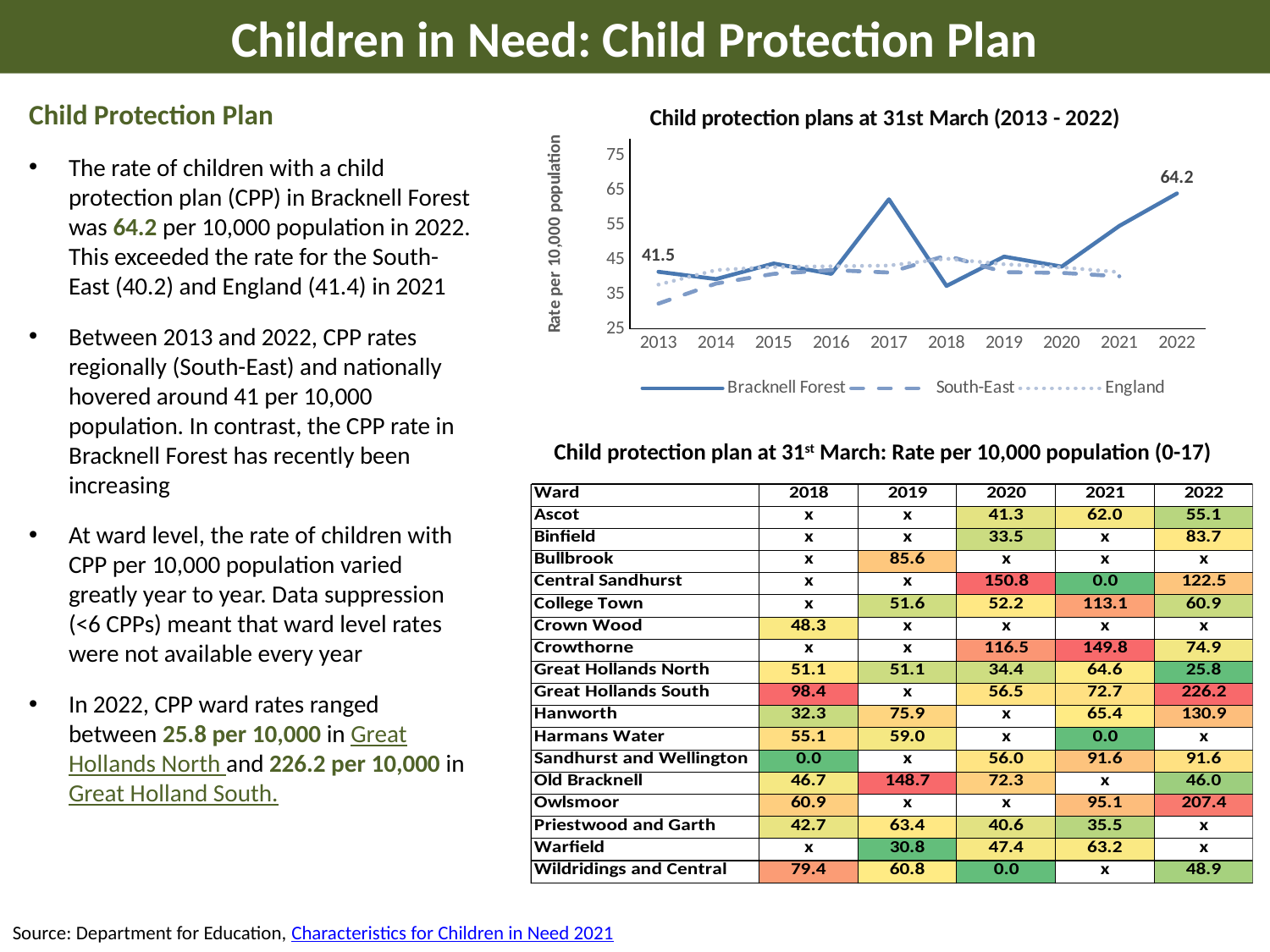
How many years are shown on the x axis of the chart? 10 By how much did the Bracknell Forest rate increase between 2013 and 2022? 22.7 What is the Bracknell Forest rate of child protection plans in 2022? 64.2 What kind of chart is shown on the slide? Line chart How many series does the legend of the chart list? 3 What is the label on the y axis of the chart? Rate per 10,000 population Does the Bracknell Forest line rise or fall between 2020 and 2022? Rises Which is larger for Bracknell Forest: the value in 2017 or the value in 2018? 2017 What is the Bracknell Forest rate of child protection plans in 2013? 41.5 Is the Bracknell Forest value for 2017 greater or less than 55? greater Is the South-East value for 2013 greater or less than 35? less Is the Bracknell Forest value for 2018 greater or less than 45? less